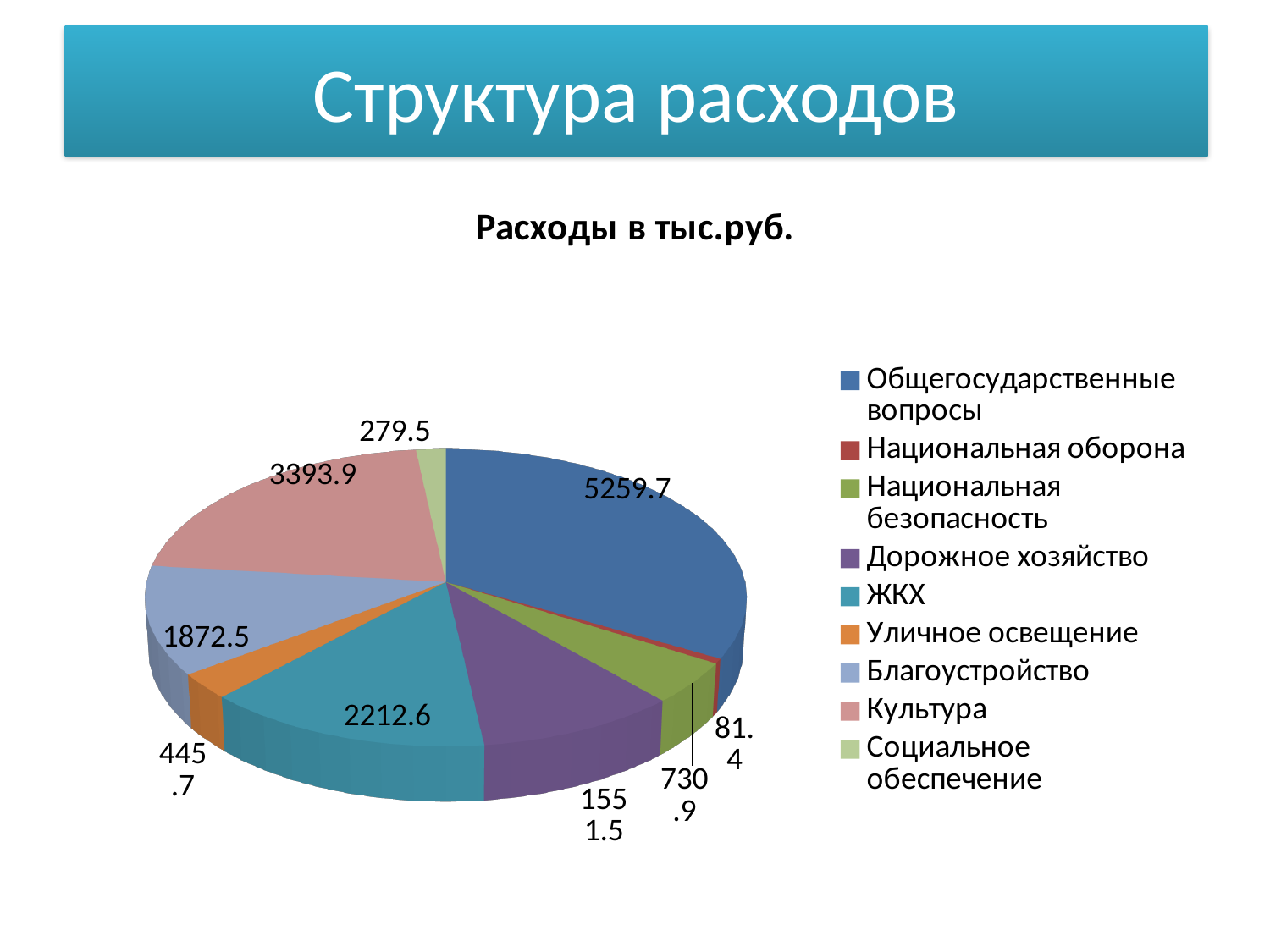
What type of chart is shown on the slide? pie chart What is the value for ЖКХ? 2212.6 How many categories does the pie chart have? 9 What is the value for Благоустройство? 1872.5 Which category has the smallest value? Национальная оборона What is the title of the chart? Расходы в тыс.руб. What is the value for Общегосударственные вопросы? 5259.7 What is the value for Культура? 3393.9 What is the value for Социальное обеспечение? 279.5 Which category has the largest value? Общегосударственные вопросы What is the difference between the values for Культура and ЖКХ? 1181.3 Which is larger, Культура or ЖКХ? Культура